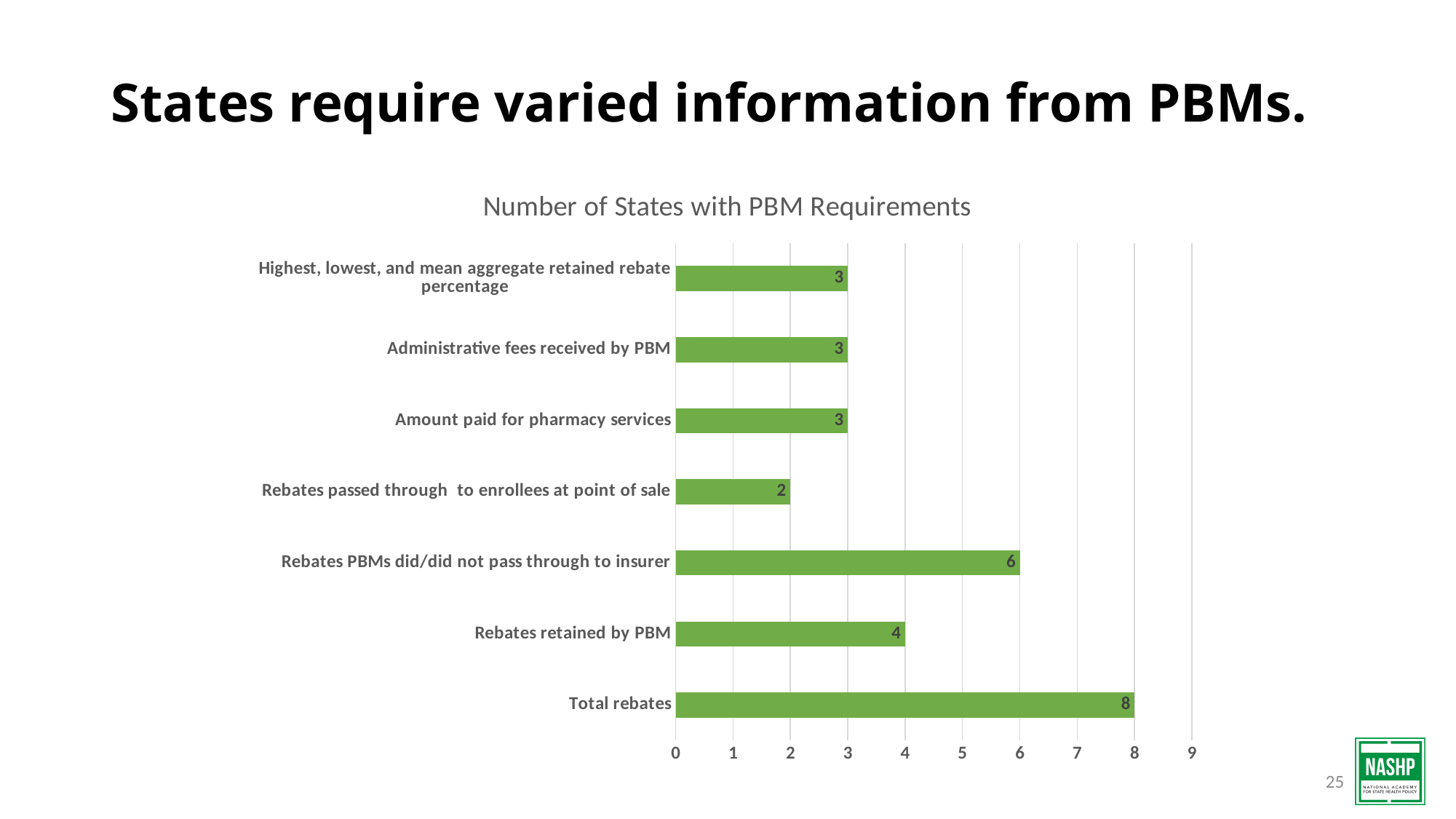
What is the value for Rebates retained by PBM? 4 What is the value for Total rebates? 8 Which is larger, the value for Rebates PBMs did/did not pass through to insurer or the value for Rebates retained by PBM? Rebates PBMs did/did not pass through to insurer What is the value for Rebates PBMs did/did not pass through to insurer? 6 How many categories are shown in the chart? 7 What is the title of the chart? Number of States with PBM Requirements Which category has the highest value? Total rebates What is the value for Administrative fees received by PBM? 3 Which category has the lowest value? Rebates passed through to enrollees at point of sale What kind of chart is shown on the slide? Bar chart What is the value for Rebates passed through to enrollees at point of sale? 2 What is the difference between the values for Total rebates and Rebates retained by PBM? 4